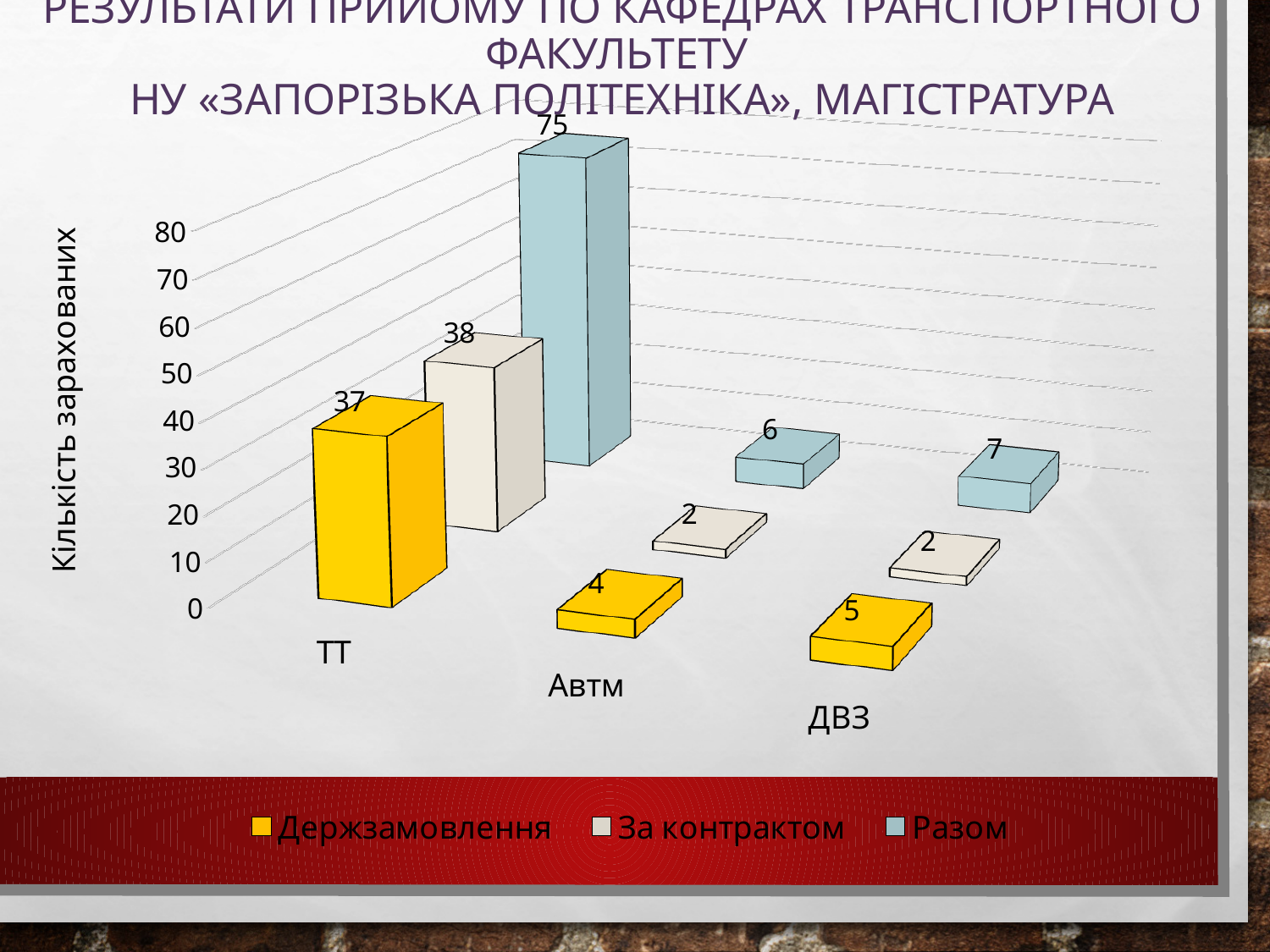
Which is larger: Держзамовлення for ТТ or За контрактом for ТТ? За контрактом for ТТ How many series does the legend list? 3 Which category has the highest Разом value? ТТ What is the difference between the Разом values for ТТ and ДВЗ? 68 What kind of chart is shown on the slide? bar chart What is the value of За контрактом for Автм? 2 What is the value of Держзамовлення for ДВЗ? 5 Is the Разом value for ТТ greater or less than 70? greater What is the label of the vertical axis? Кількість зарахованих How many categories are shown on the x axis? 3 Which category has the lowest Держзамовлення value? Автм What is the value of Разом for ТТ? 75